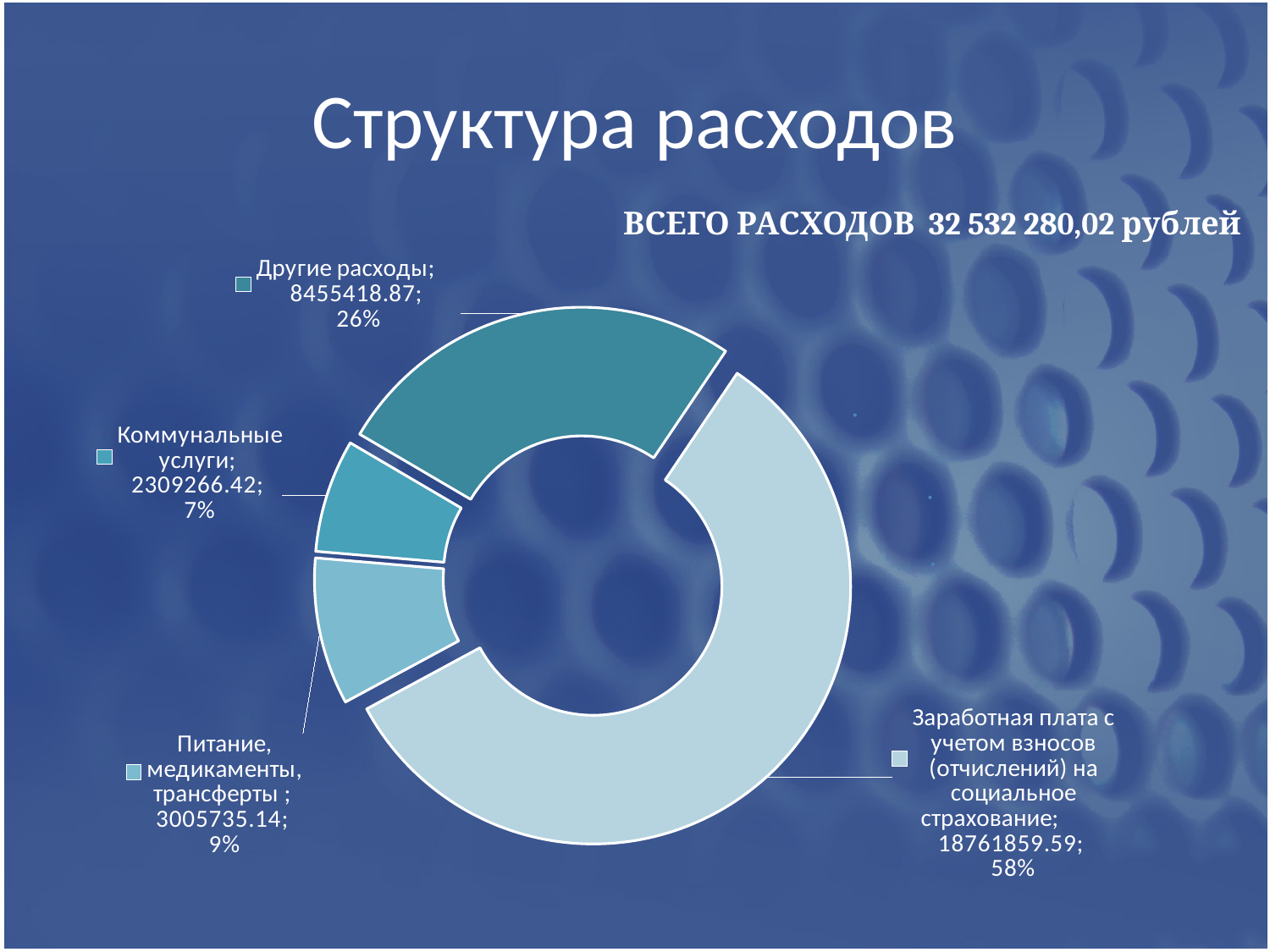
Which category has the smallest share of the chart? Коммунальные услуги What is the value shown for Другие расходы? 8455418.87 What percentage share is shown for Коммунальные услуги? 7% Which category has the largest share of the chart? Заработная плата с учетом взносов (отчислений) на социальное страхование What is the difference between the values for Другие расходы and Коммунальные услуги? 6146152.45 What is the value shown for Питание, медикаменты, трансферты? 3005735.14 Which is larger: the value for Другие расходы or the value for Питание, медикаменты, трансферты? Другие расходы What percentage share is shown for Заработная плата с учетом взносов (отчислений) на социальное страхование? 58% What is the difference in percentage share between Заработная плата с учетом взносов (отчислений) на социальное страхование and Другие расходы? 32% How many categories are shown in the chart? 4 What is the title of the chart on the slide? Структура расходов What kind of chart is shown on the slide? Doughnut (pie) chart